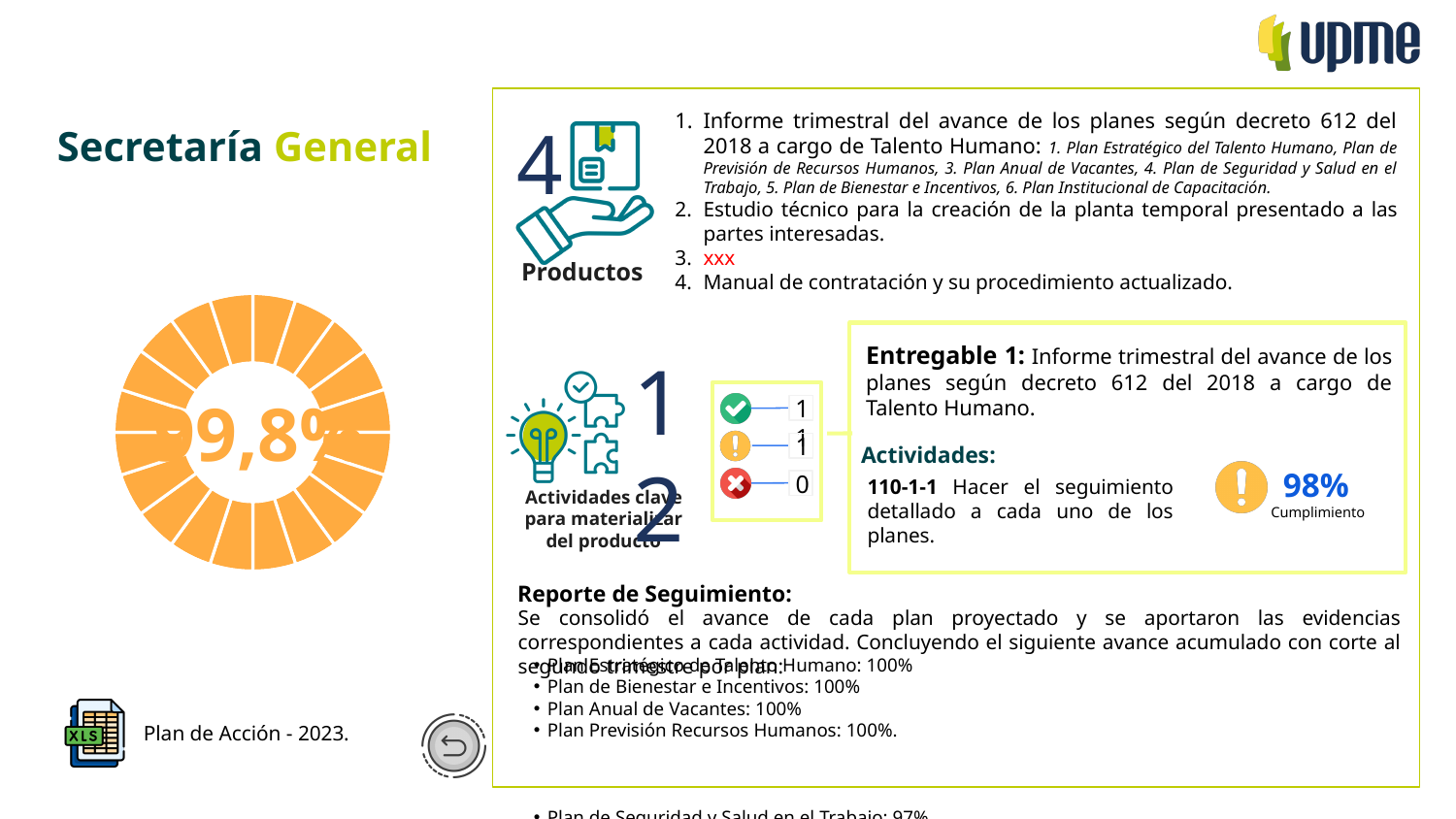
What percentage of 'Cumplimiento' is shown in the Entregable 1 box? 98% Does the donut chart on the left of the slide show a value greater or less than 50%? greater What colour is the ring of the donut chart on the left of the slide? Orange In the status indicator next to 'Actividades clave para materializar del producto', what number is shown beside the yellow exclamation icon? 1 How many status rows are listed in the indicator next to 'Actividades clave para materializar del producto'? 3 In the status indicator next to 'Actividades clave para materializar del producto', what number is shown beside the red X icon? 0 What kind of chart is shown on the left side of the slide under the title 'Secretaría General'? Pie chart (donut) In the status indicator next to 'Actividades clave para materializar del producto', what number is shown beside the green check icon? 1